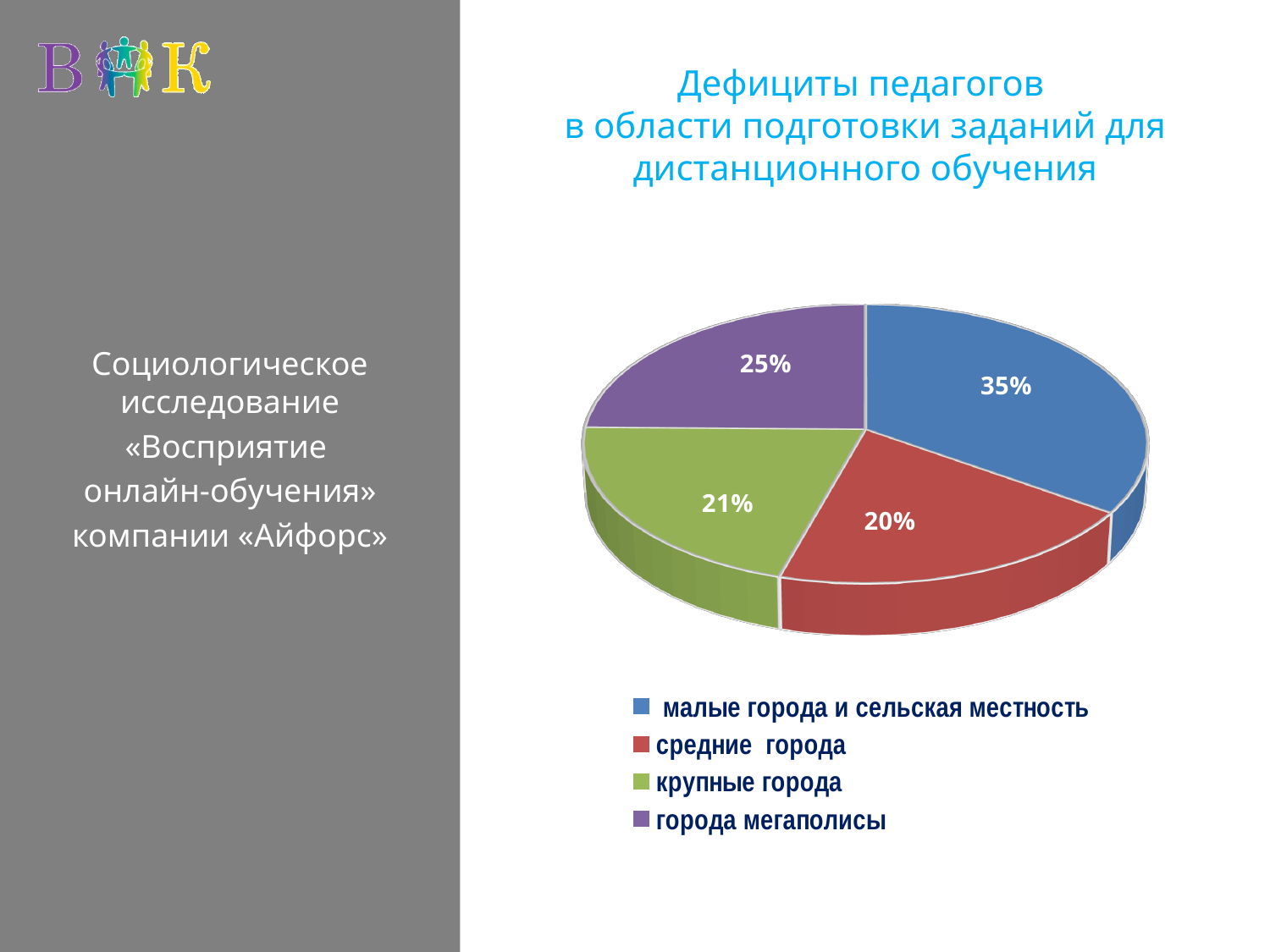
What percentage is shown for средние города? 20% What is the title of the chart? Дефициты педагогов в области подготовки заданий для дистанционного обучения What colour is the slice for крупные города? green What percentage is shown for города мегаполисы? 25% What is the difference in percentage points between малые города и сельская местность and города мегаполисы? 10 Which is larger: the slice for города мегаполисы or the slice for крупные города? города мегаполисы What type of chart is shown on the slide? pie chart What share of the pie is labelled for малые города и сельская местность? 35% Which category has the smallest slice of the pie? средние города How many slices does the pie chart have? 4 What percentage is shown for крупные города? 21% Which category has the largest slice of the pie? малые города и сельская местность